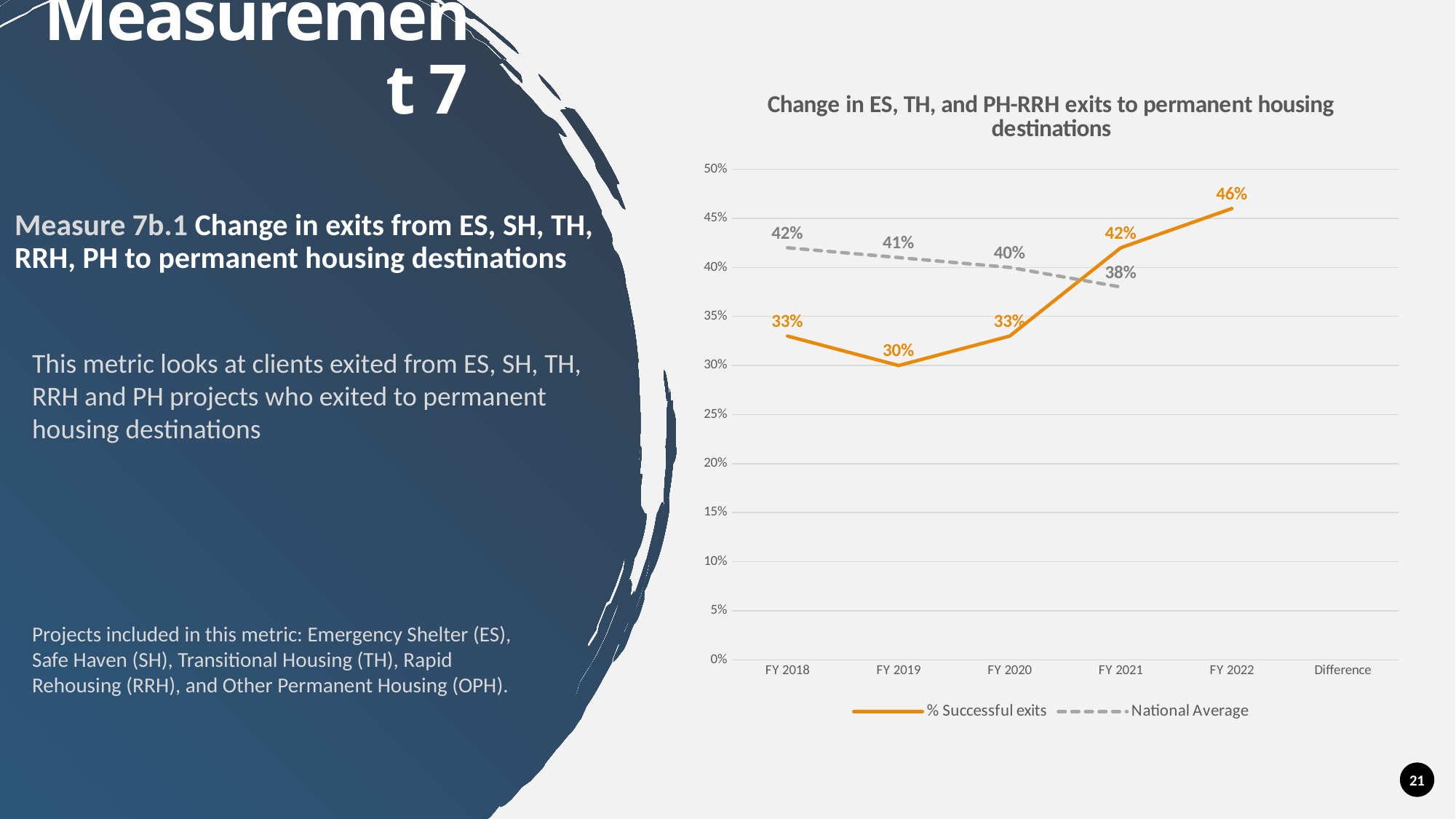
What is the % Successful exits value for FY 2019? 30% In which fiscal year is the % Successful exits value lowest? FY 2019 What is the % Successful exits value for FY 2022? 46% What is the National Average value for FY 2018? 42% Does the National Average line rise or fall from FY 2018 to FY 2021? Fall In FY 2021, which is larger: % Successful exits or National Average? % Successful exits In which fiscal year is the % Successful exits value highest? FY 2022 In FY 2018, which is larger: % Successful exits or National Average? National Average What kind of chart is shown on the slide? Line chart What is the National Average value for FY 2021? 38% How many series does the legend list? 2 What is the difference between the % Successful exits values for FY 2022 and FY 2018? 13%